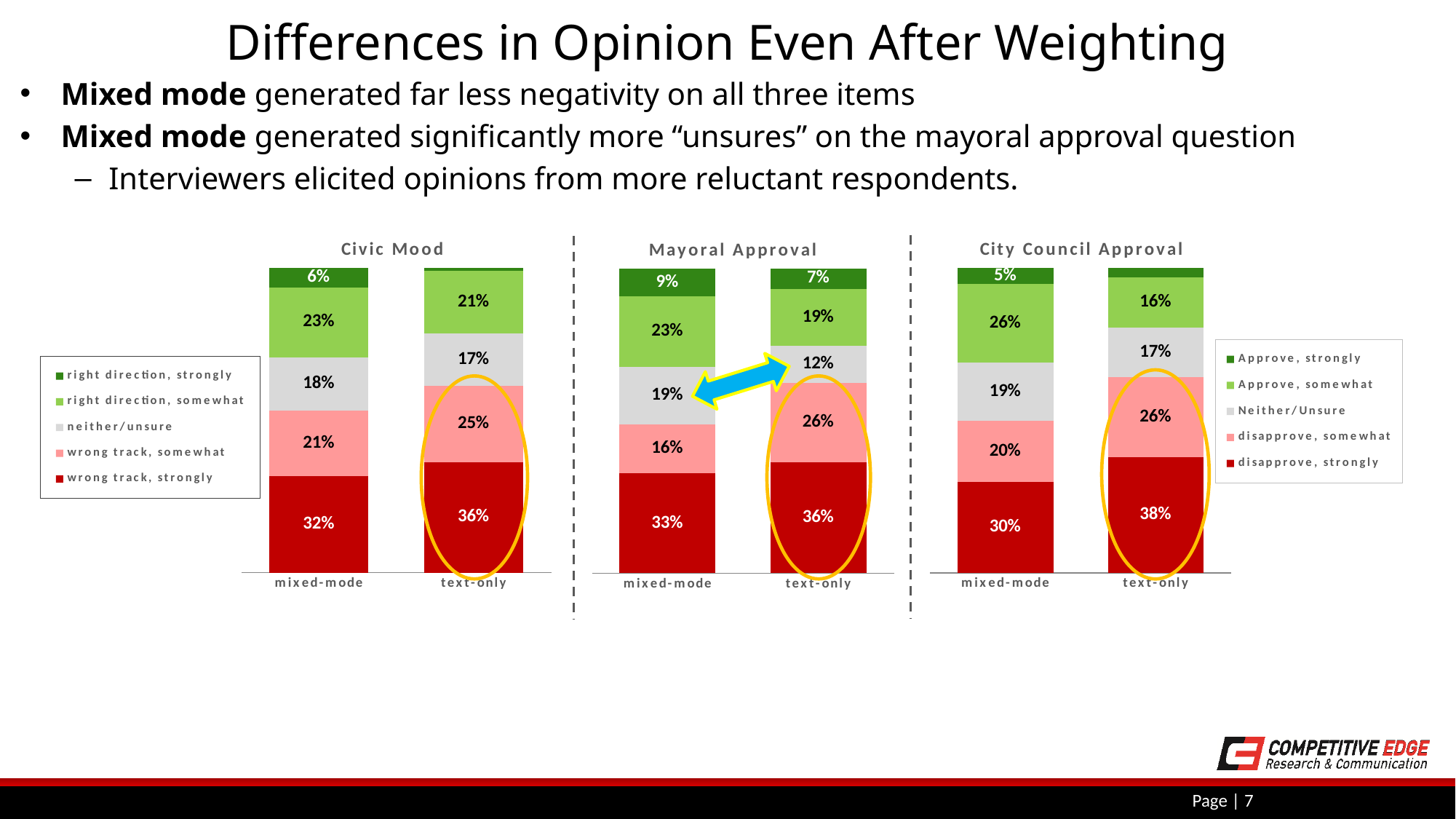
In the Civic Mood chart, which bar has the larger 'wrong track, somewhat' value, mixed-mode or text-only? text-only In the Mayoral Approval chart, what is the difference between the 'Neither/Unsure' values for mixed-mode and text-only? 7% In the City Council Approval chart, what is the value for 'Approve, somewhat' in the mixed-mode bar? 26% In the Civic Mood chart, what is the value for 'neither/unsure' in the text-only bar? 17% In the Mayoral Approval chart, what is the value for 'Neither/Unsure' in the mixed-mode bar? 19% In the City Council Approval chart, what is the difference between the 'disapprove, strongly' values for text-only and mixed-mode? 8% What kind of chart is the Civic Mood chart? Stacked bar chart In the City Council Approval chart, what is the value for 'disapprove, strongly' in the text-only bar? 38% How many bars are shown in the City Council Approval chart? 2 In the Civic Mood chart, what is the value for 'wrong track, strongly' in the mixed-mode bar? 32% In the Mayoral Approval chart, what is the value for 'Approve, strongly' in the text-only bar? 7%